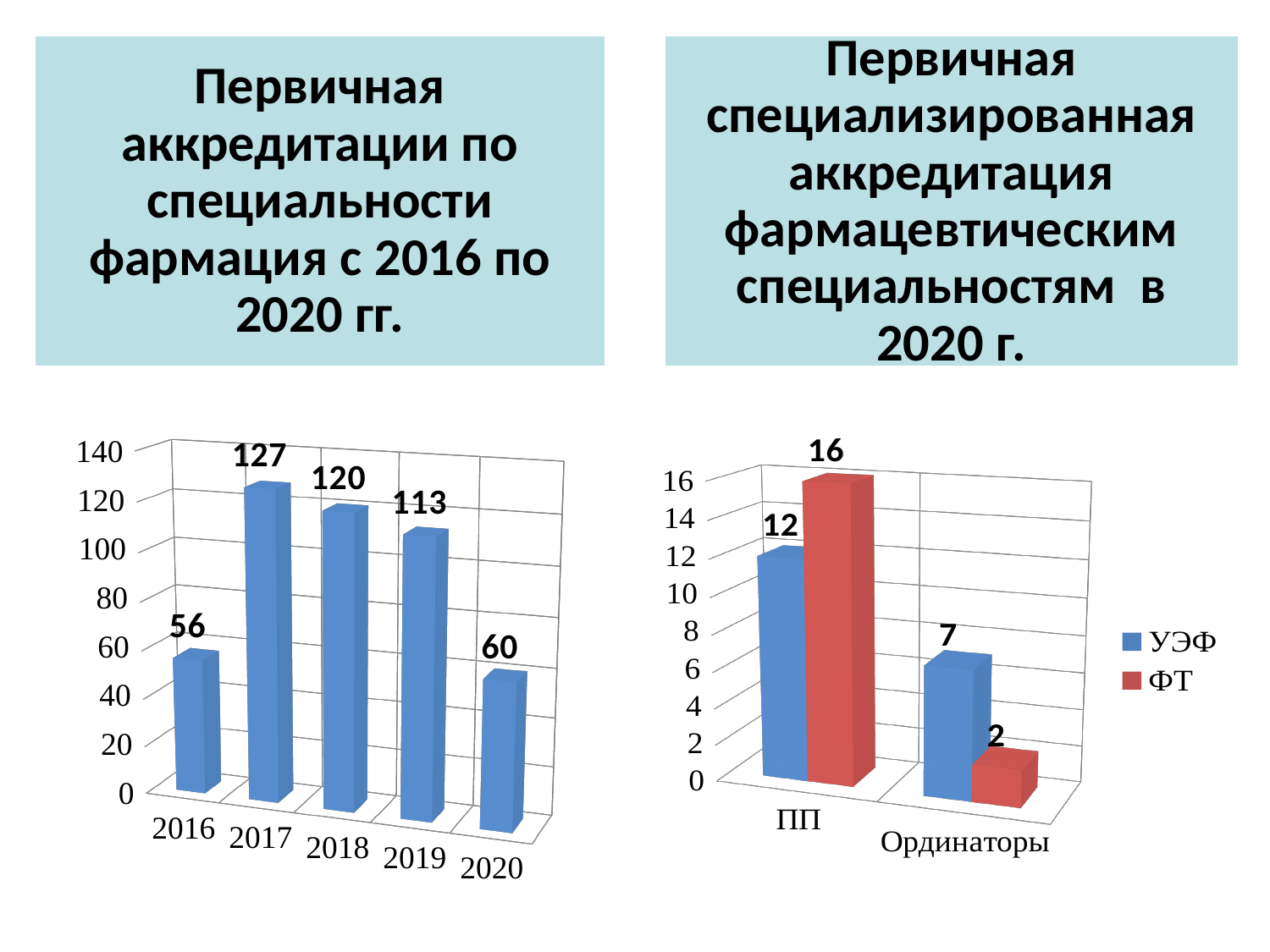
In the left chart (Первичная аккредитации по специальности фармация с 2016 по 2020 гг.), what is the value for 2017? 127 In the right chart (Первичная специализированная аккредитация фармацевтическим специальностям в 2020 г.), how many series does the legend list? 2 In the right chart (Первичная специализированная аккредитация фармацевтическим специальностям в 2020 г.), which is larger for Ординаторы, УЭФ or ФТ? УЭФ What kind of chart is the right chart (Первичная специализированная аккредитация фармацевтическим специальностям в 2020 г.)? bar chart In the left chart (Первичная аккредитации по специальности фармация с 2016 по 2020 гг.), do the values rise or fall from 2017 to 2020? fall In the left chart (Первичная аккредитации по специальности фармация с 2016 по 2020 гг.), what is the value for 2016? 56 In the left chart (Первичная аккредитации по специальности фармация с 2016 по 2020 гг.), which year has the highest value? 2017 In the left chart (Первичная аккредитации по специальности фармация с 2016 по 2020 гг.), which year has the lowest value? 2016 In the right chart (Первичная специализированная аккредитация фармацевтическим специальностям в 2020 г.), what is the value of УЭФ for Ординаторы? 7 In the left chart (Первичная аккредитации по специальности фармация с 2016 по 2020 гг.), what is the difference between the values for 2018 and 2019? 7 In the left chart (Первичная аккредитации по специальности фармация с 2016 по 2020 гг.), how many years are shown on the x axis? 5 In the right chart (Первичная специализированная аккредитация фармацевтическим специальностям в 2020 г.), what is the value of ФТ for ПП? 16